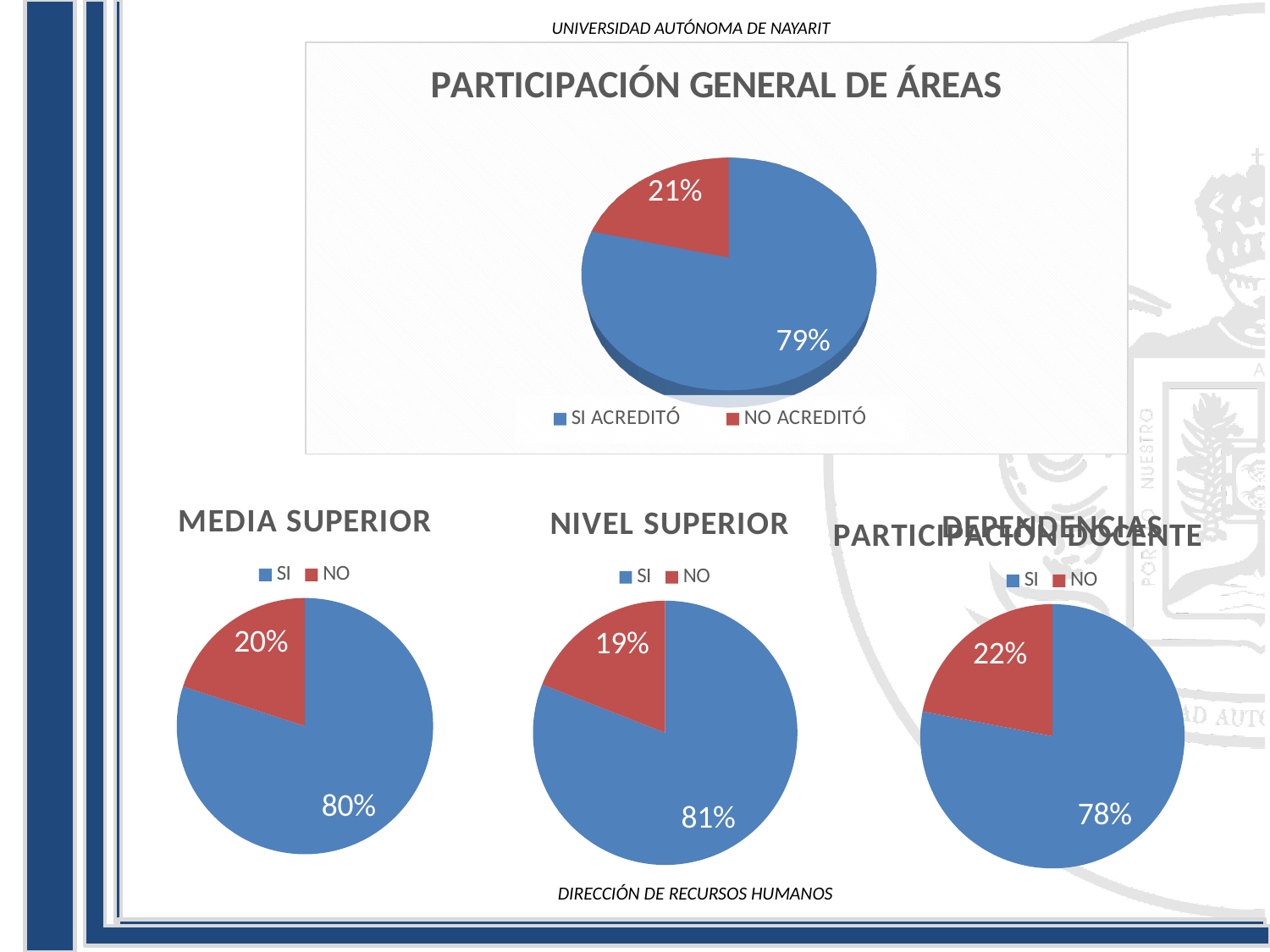
In the NIVEL SUPERIOR chart, what is the difference between the SI and NO shares? 62% In the PARTICIPACIÓN GENERAL DE ÁREAS chart, what share of the pie is SI ACREDITÓ? 79% In the PARTICIPACIÓN GENERAL DE ÁREAS chart, what share of the pie is NO ACREDITÓ? 21% In the bottom-right pie chart, what share of the pie is SI? 78% In the MEDIA SUPERIOR chart, which slice is larger, SI or NO? SI What kind of chart is the PARTICIPACIÓN GENERAL DE ÁREAS chart? Pie chart How many entries does the legend of the PARTICIPACIÓN GENERAL DE ÁREAS chart list? 2